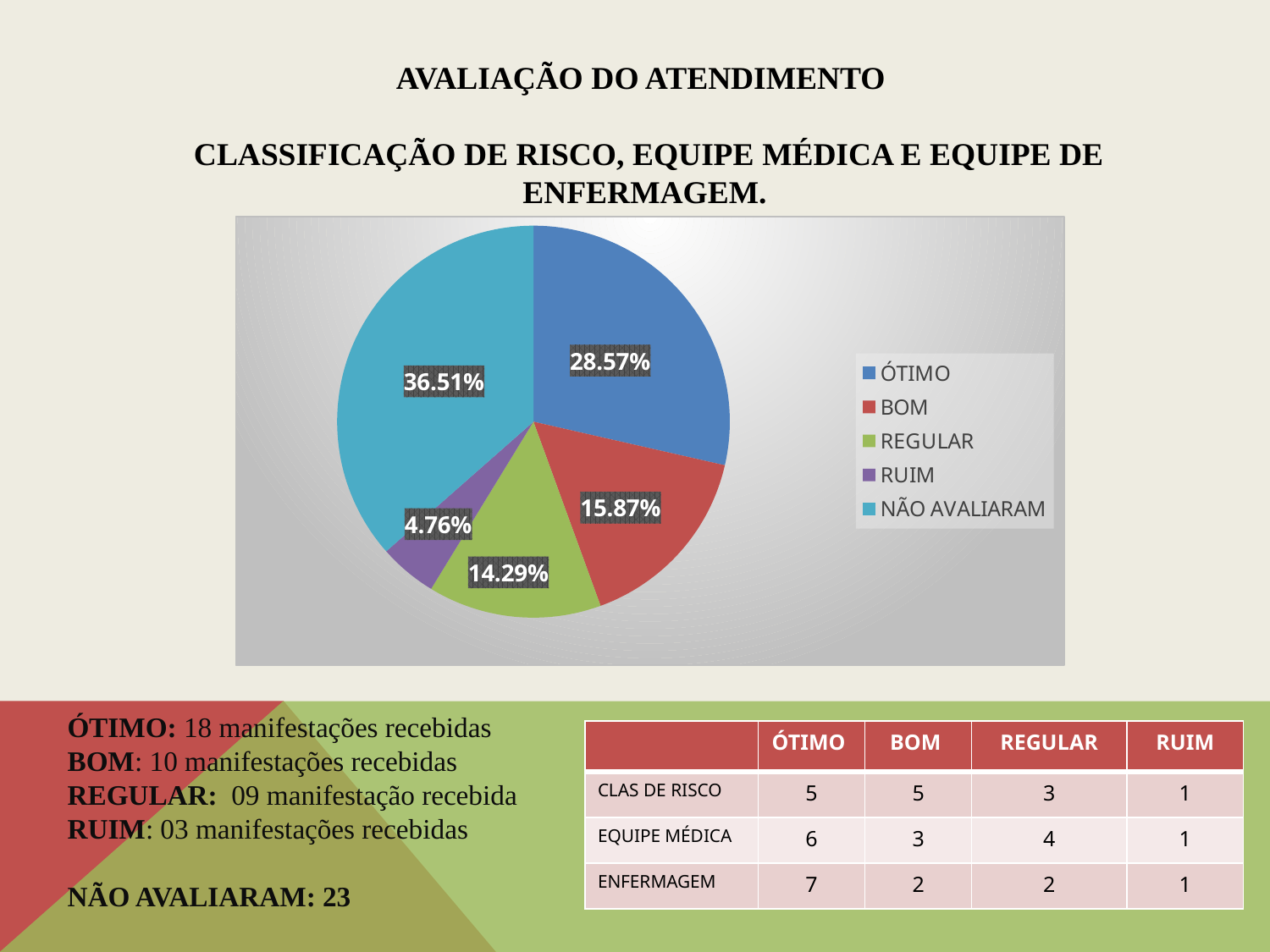
How many entries does the legend of the pie chart list? 5 Which category has the largest slice of the pie? NÃO AVALIARAM What is the value shown for BOM in the pie chart? 15.87% What kind of chart is shown on the slide? pie chart What is the value shown for REGULAR in the pie chart? 14.29% What share of the pie does NÃO AVALIARAM represent? 36.51% Which category has the smallest slice of the pie? RUIM Which is larger in the pie chart, ÓTIMO or BOM? ÓTIMO What is the value shown for RUIM in the pie chart? 4.76% What share of the pie does ÓTIMO represent? 28.57% How many slices does the pie chart have? 5 What is the difference in percentage points between NÃO AVALIARAM and ÓTIMO? 7.94%